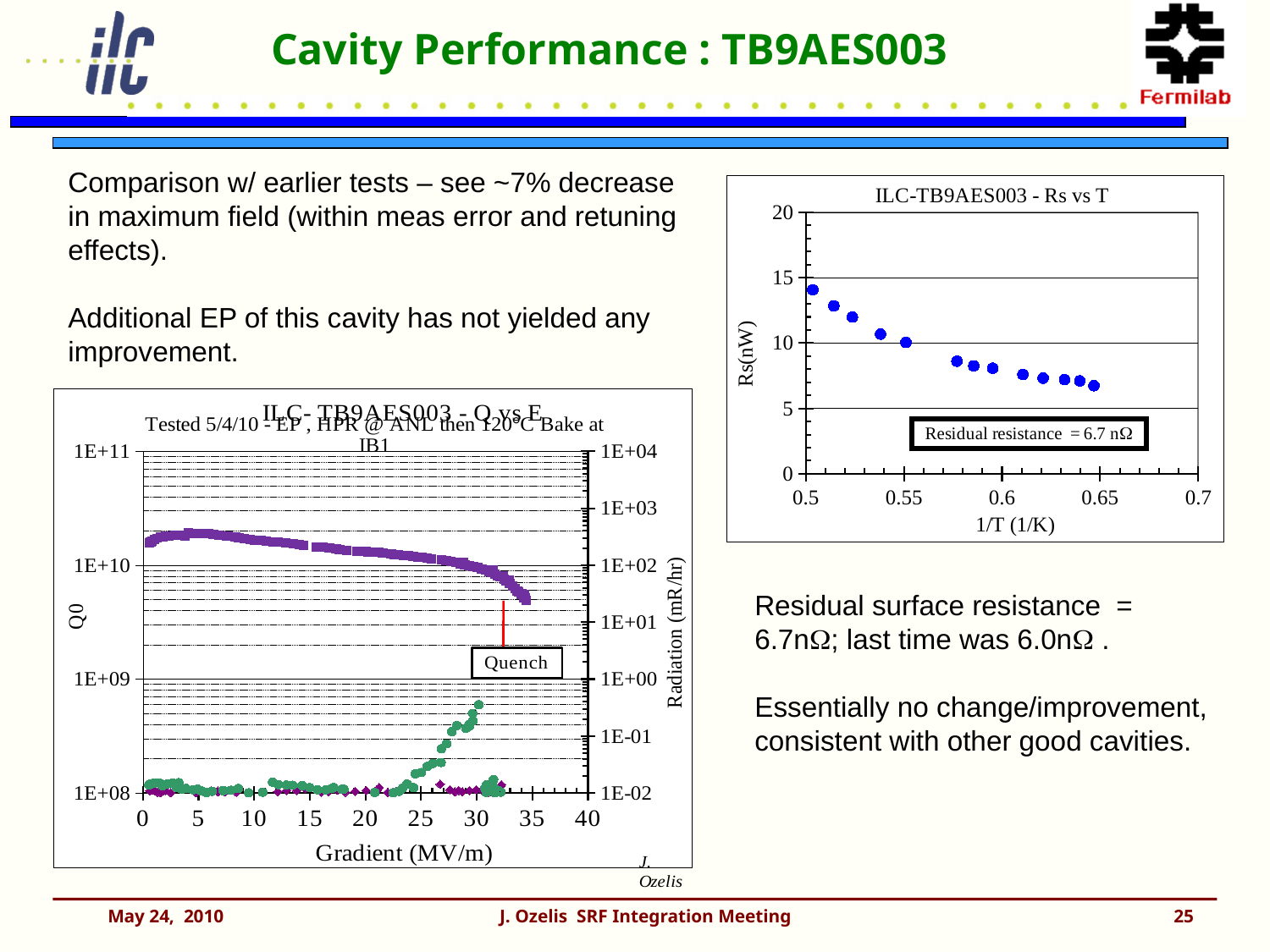
What kind of chart is the 'ILC-TB9AES003 - Rs vs T' chart? scatter chart In the 'ILC- TB9AES003 - Q vs E' chart, is the highest gradient reached greater or less than 35 MV/m? less In the 'ILC- TB9AES003 - Q vs E' chart, is the Q0 value at a gradient of 5 MV/m greater or less than 1E+10? greater In the 'ILC- TB9AES003 - Q vs E' chart, what is the label of the x axis? Gradient (MV/m) In the 'ILC- TB9AES003 - Q vs E' chart, does Q0 rise or fall as the gradient increases along the x axis? fall In the 'ILC-TB9AES003 - Rs vs T' chart, what residual resistance value is printed in the box on the plot? 6.7 nΩ In the 'ILC-TB9AES003 - Rs vs T' chart, what is the label of the y axis? Rs(nW) In the 'ILC-TB9AES003 - Rs vs T' chart, is the Rs value at 1/T = 0.65 greater or less than 10? less In the 'ILC-TB9AES003 - Rs vs T' chart, what is the label of the x axis? 1/T (1/K) In the 'ILC-TB9AES003 - Rs vs T' chart, does Rs rise or fall as 1/T increases along the x axis? fall In the 'ILC- TB9AES003 - Q vs E' chart, what event is marked by the annotation with the red vertical line? Quench